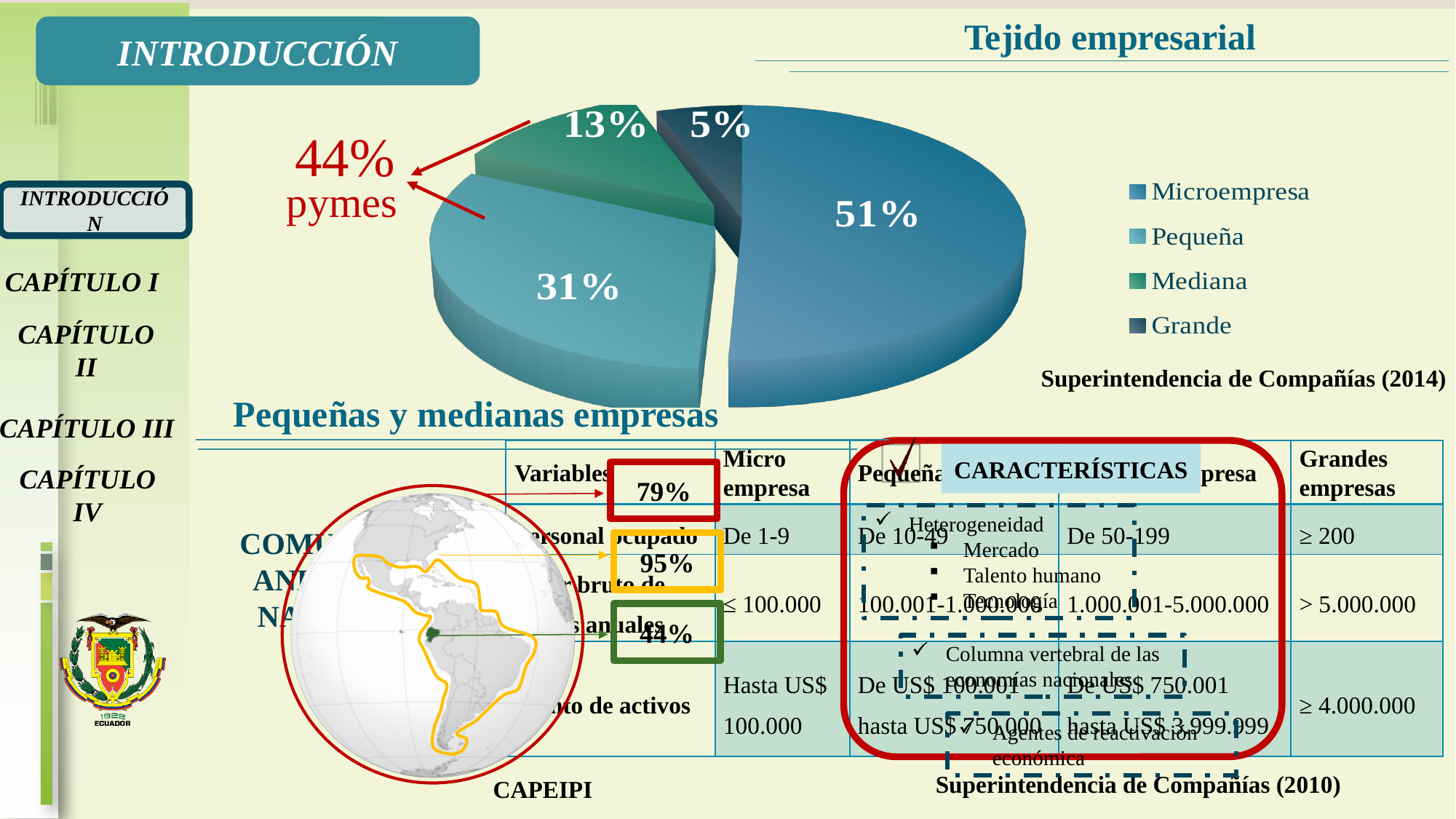
In the "Tejido empresarial" pie chart, what share does Microempresa have? 51% In the "Tejido empresarial" pie chart, what is the difference between the Microempresa and Pequeña shares? 20% In the "Tejido empresarial" pie chart, what share does Mediana have? 13% Which category has the smallest slice in the "Tejido empresarial" pie chart? Grande Which category has the largest slice in the "Tejido empresarial" pie chart? Microempresa In the "Tejido empresarial" pie chart, what share does Pequeña have? 31% In the "Tejido empresarial" pie chart, what is the combined share of Pequeña and Mediana? 44% In the "Tejido empresarial" pie chart, which is larger: Mediana or Grande? Mediana In the "Tejido empresarial" pie chart, what share does Grande have? 5% How many categories does the legend of the "Tejido empresarial" pie chart list? 4 What source is cited below the "Tejido empresarial" pie chart? Superintendencia de Compañías (2014) What kind of chart is shown under the title "Tejido empresarial"? pie chart